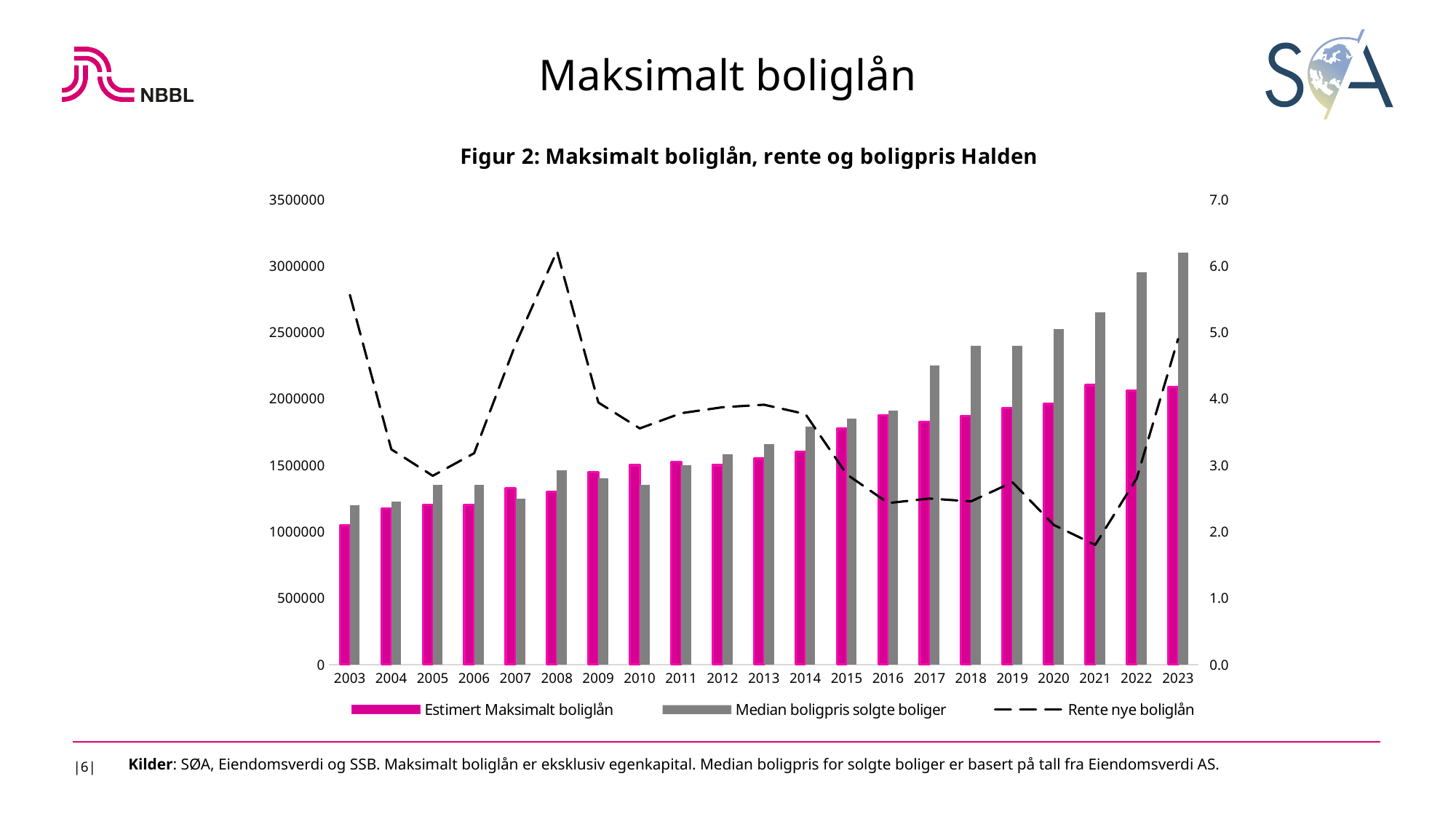
Is the Median boligpris solgte boliger for 2023 greater or less than 3000000? greater In 2023, which is larger: Estimert Maksimalt boliglån or Median boligpris solgte boliger? Median boligpris solgte boliger In which year is the Median boligpris solgte boliger highest? 2023 How many series does the chart legend list? 3 Is the Rente nye boliglån for 2008 greater or less than 6.0? greater What kind of chart is shown on the slide? A combined bar and line chart What is the title of the chart? Figur 2: Maksimalt boliglån, rente og boligpris Halden In which year is the Median boligpris solgte boliger lowest? 2003 Is the Rente nye boliglån for 2021 greater or less than 2.0? less In which year is the Estimert Maksimalt boliglån lowest? 2003 Does the Median boligpris solgte boliger generally rise or fall from 2003 to 2023? Rise How many years are shown along the x axis of the chart? 21